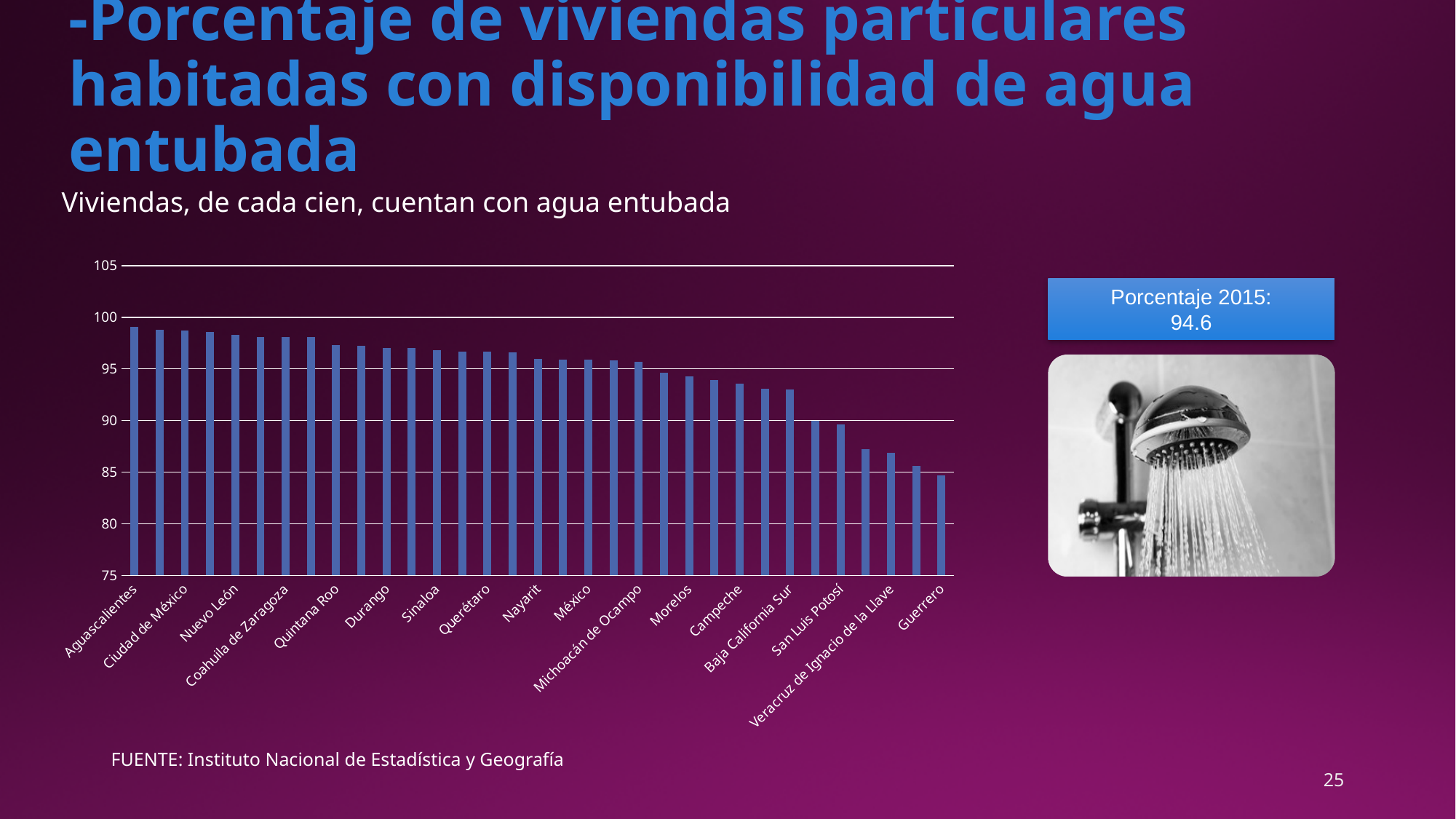
Is the value for Veracruz de Ignacio de la Llave greater or less than 90? less Is the value for Baja California Sur greater or less than 95? less What kind of chart is shown on the slide? bar chart Which has a higher value, Aguascalientes or Guerrero? Aguascalientes What is the highest value shown on the vertical axis of the chart? 105 Which state has the lowest percentage of homes with piped water in the chart? Guerrero Is the value for Durango greater or less than 95? greater Do the values rise or fall moving from left to right along the x axis? fall Which has a higher value, Durango or Campeche? Durango What national percentage for 2015 is shown in the box next to the chart? 94.6